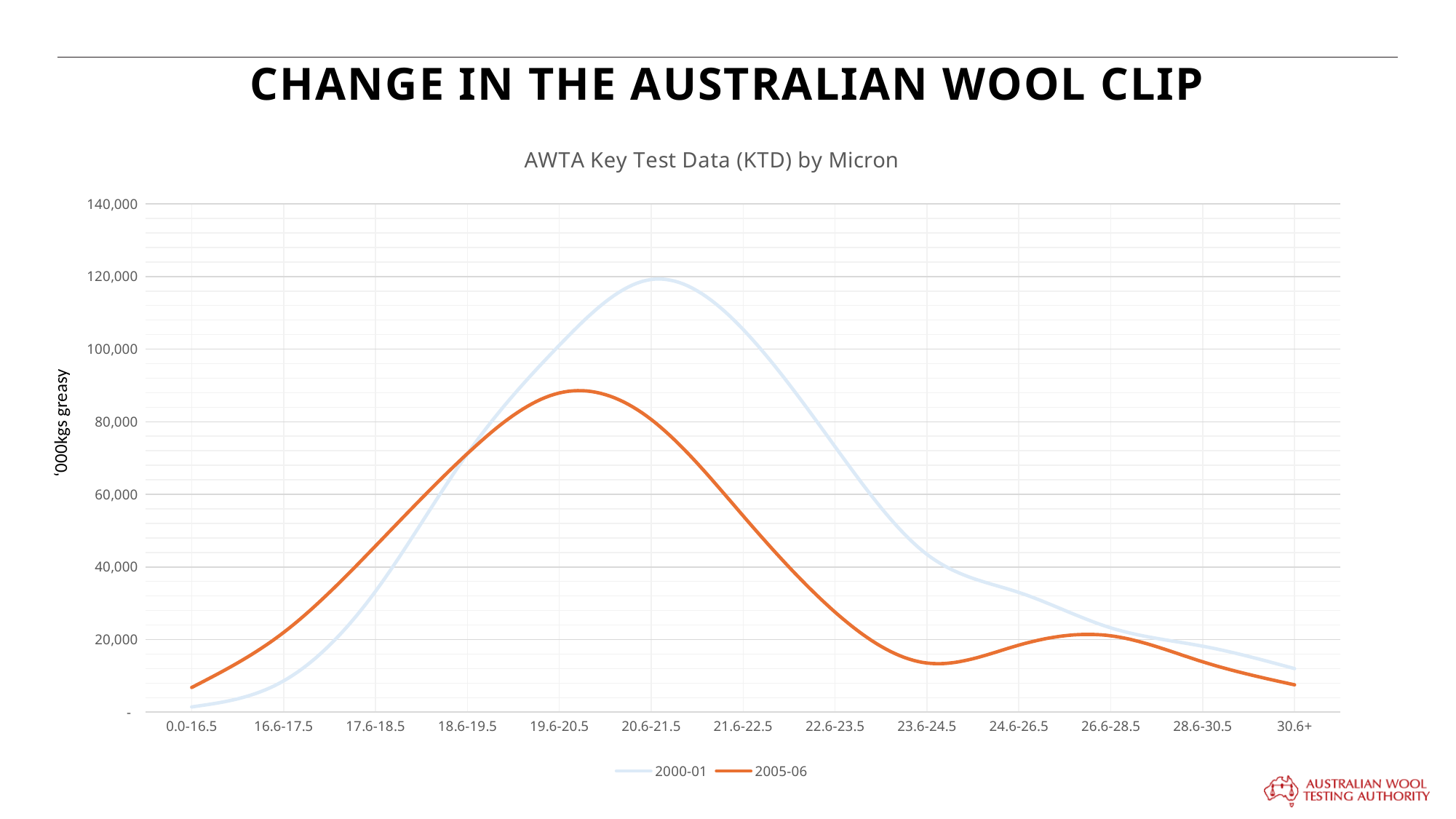
Is the value for 2005-06 at 19.6-20.5 greater or less than 80,000? greater Which series has the larger value at 17.6-18.5, 2000-01 or 2005-06? 2005-06 What is the label on the y axis? '000kgs greasy Is the value for 2005-06 at 23.6-24.5 greater or less than 20,000? less How many series does the legend list? 2 In which micron category does the 2005-06 series reach its highest value? 19.6-20.5 In which micron category does the 2000-01 series reach its highest value? 20.6-21.5 Is the value for 2000-01 at 20.6-21.5 greater or less than 100,000? greater Which series has the larger value at 20.6-21.5, 2000-01 or 2005-06? 2000-01 What kind of chart is shown on the slide? Line chart In which micron category is the 2000-01 series at its lowest value? 0.0-16.5 How many micron categories are shown on the x axis? 13